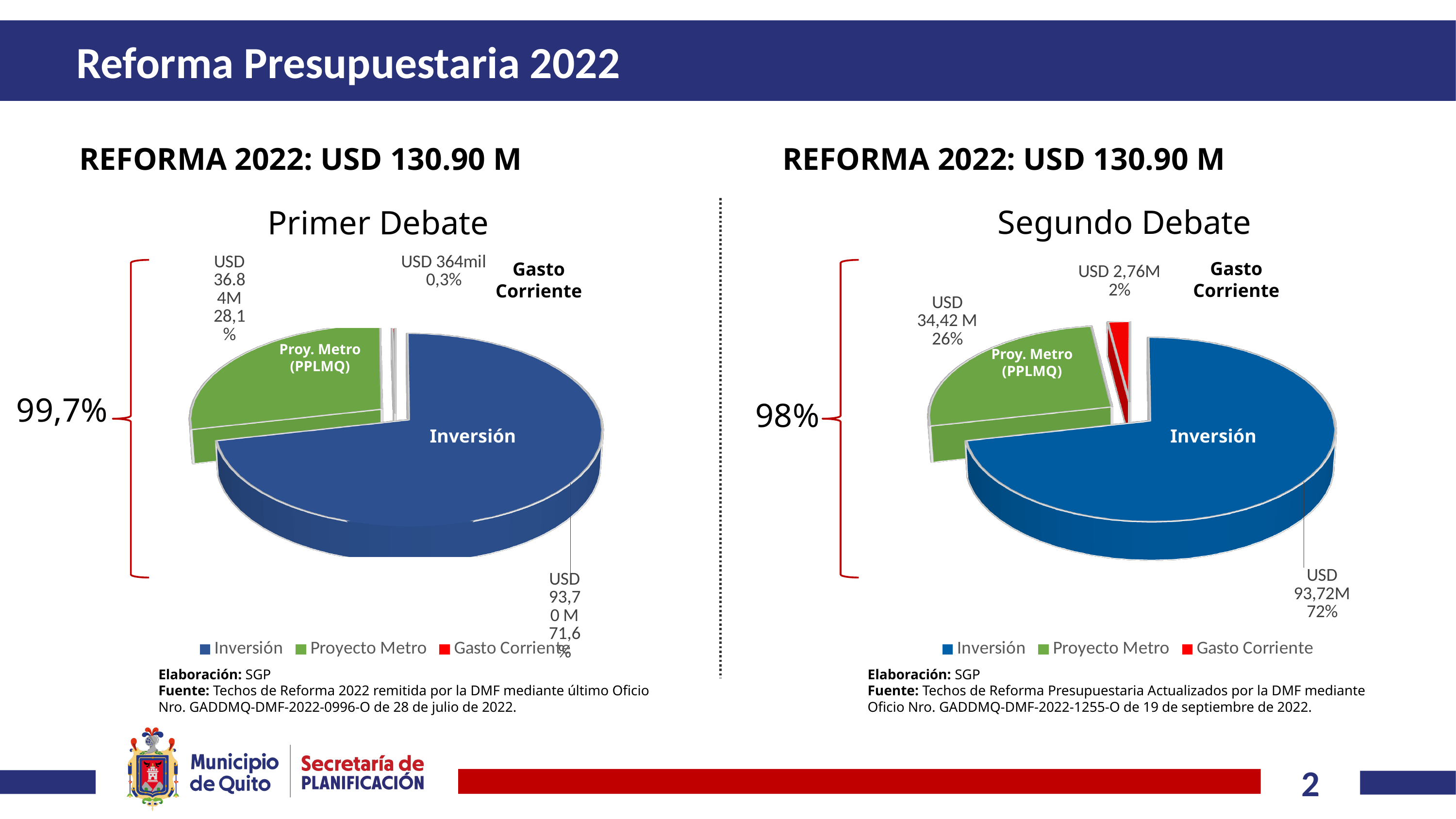
In the "Primer Debate" chart, what is the value shown for Proyecto Metro (PPLMQ)? USD 36.84M In the "Primer Debate" chart, what share of the pie does Inversión represent? 71,6% In the "Segundo Debate" chart, what is the value shown for Gasto Corriente? USD 2,76M In the "Primer Debate" chart, what colour is the Proyecto Metro slice? Green In the "Segundo Debate" chart, what is the value shown for Inversión? USD 93,72M How many categories does the legend of the "Segundo Debate" chart list? 3 What kind of chart is the "Primer Debate" chart? Pie chart In the "Segundo Debate" chart, what share of the pie does Proyecto Metro represent? 26% In the "Primer Debate" chart, which category has the smallest slice? Gasto Corriente In the "Primer Debate" chart, what is the value shown for Gasto Corriente? USD 364mil In the "Segundo Debate" chart, which is larger, the share for Proyecto Metro or the share for Gasto Corriente? Proyecto Metro In the "Segundo Debate" chart, which category has the largest slice? Inversión